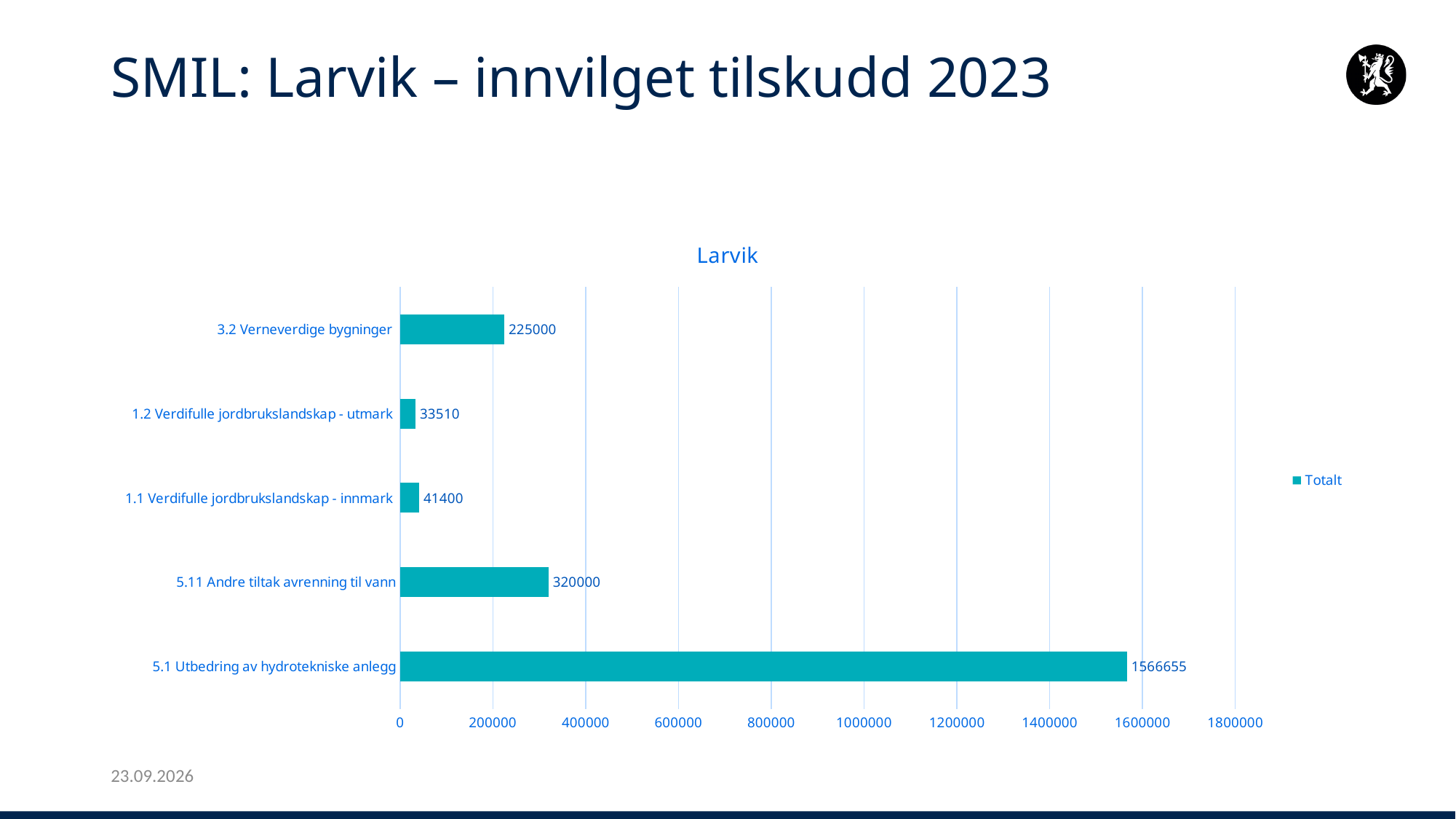
Which is larger, the value for 1.1 Verdifulle jordbrukslandskap - innmark or 1.2 Verdifulle jordbrukslandskap - utmark? 1.1 Verdifulle jordbrukslandskap - innmark What is the title of the chart? Larvik How many categories are shown in the chart? 5 What is the value for 3.2 Verneverdige bygninger? 225000 Which category has the lowest value? 1.2 Verdifulle jordbrukslandskap - utmark How many series does the legend list? 1 What is the value for 5.1 Utbedring av hydrotekniske anlegg? 1566655 What is the difference between the values for 5.11 Andre tiltak avrenning til vann and 3.2 Verneverdige bygninger? 95000 Which category has the highest value? 5.1 Utbedring av hydrotekniske anlegg What kind of chart is shown on the slide? bar chart Is the value for 5.1 Utbedring av hydrotekniske anlegg greater or less than 1400000? greater What is the value for 1.2 Verdifulle jordbrukslandskap - utmark? 33510